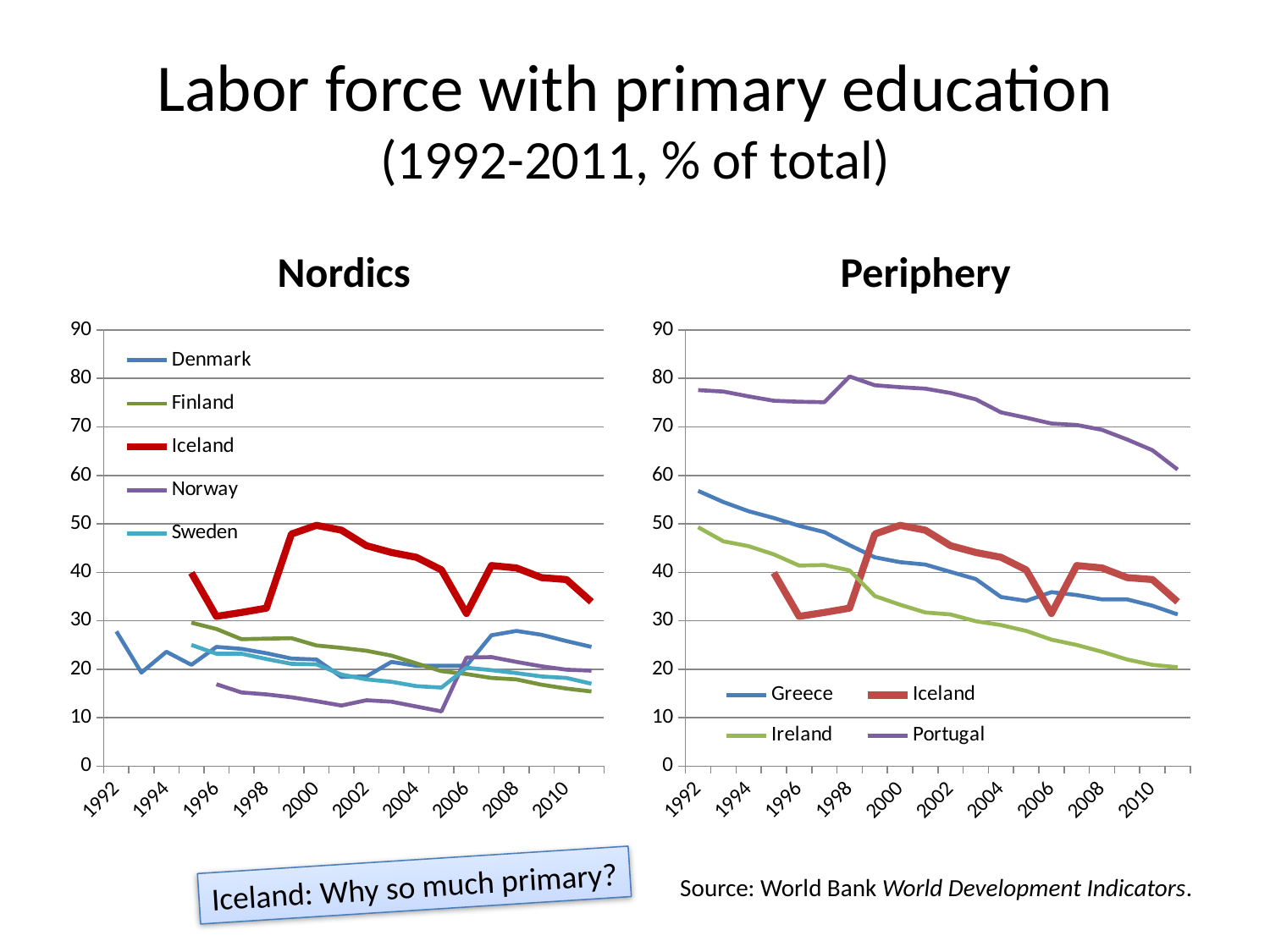
In the Nordics chart, is the value for Norway in 2005 greater or less than 20? less How many series does the legend of the Nordics chart list? 5 In the Periphery chart, which country has the highest values across the whole period? Portugal In the Periphery chart, is the value for Portugal in 1992 greater or less than 70? greater In the Nordics chart, which country has the lowest value in 2005? Norway In the Periphery chart, does the value for Ireland rise or fall over the period shown? fall In the Nordics chart, which country is drawn with the thick red line? Iceland In the Periphery chart, does the value for Portugal rise or fall from 1992 to 2011? fall In the Periphery chart, which is larger in 1992, the value for Greece or the value for Ireland? Greece How many series does the legend of the Periphery chart list? 4 What kind of chart is the Nordics chart? line chart In the Nordics chart, which country has the highest value in 2000? Iceland